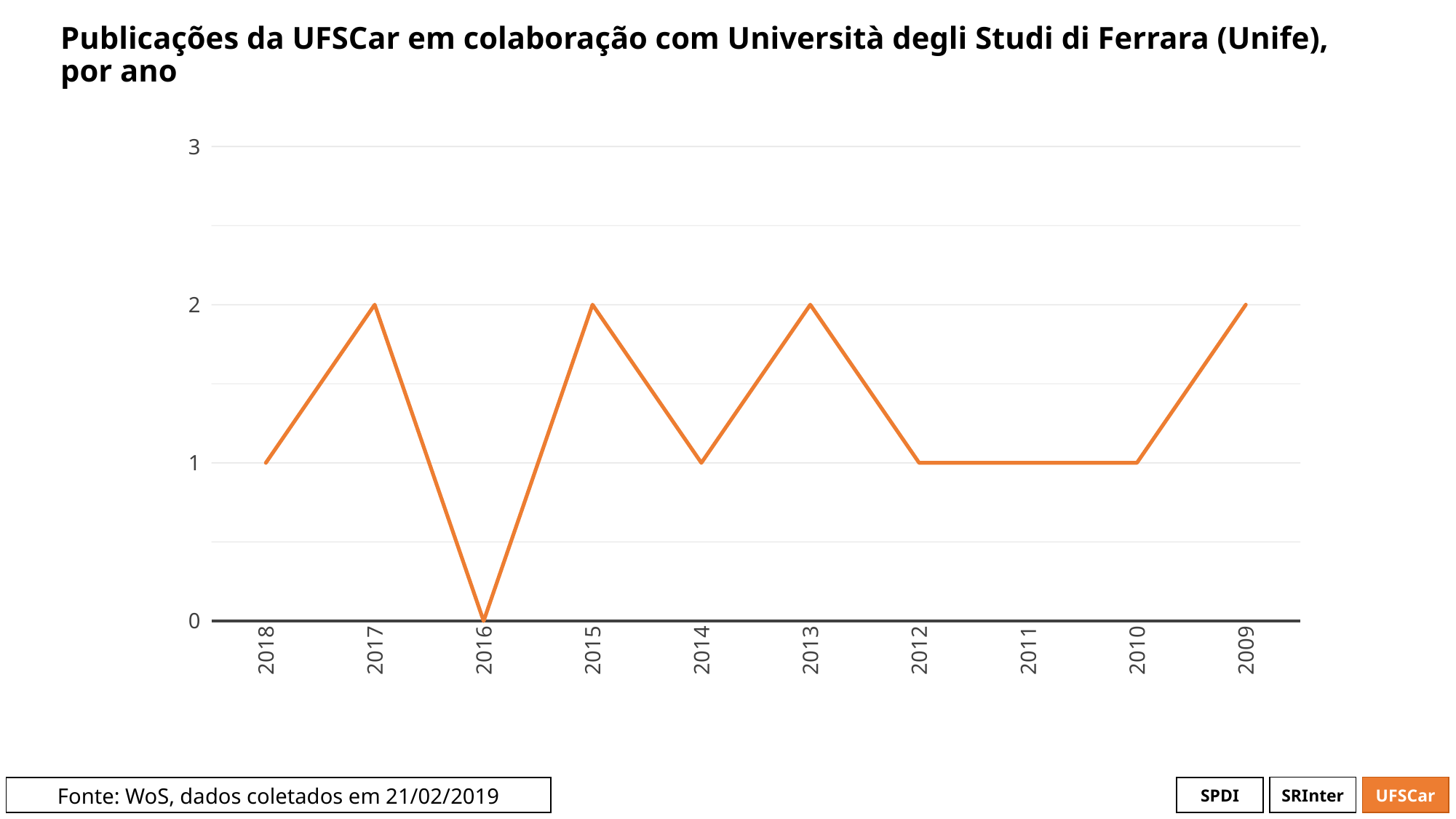
What type of chart is shown on the slide? line chart What is the value for 2016? 0 Which is larger, the value for 2013 or the value for 2012? 2013 What is the difference between the values for 2015 and 2014? 1 How many years are plotted on the x axis? 10 What is the value for 2018? 1 Is the value for 2009 greater or less than 1? greater What is the highest value shown on the y axis? 3 What is the value for 2017? 2 Does the line rise or fall from 2010 to 2009? rise Which year has the lowest value? 2016 What is the value for 2011? 1